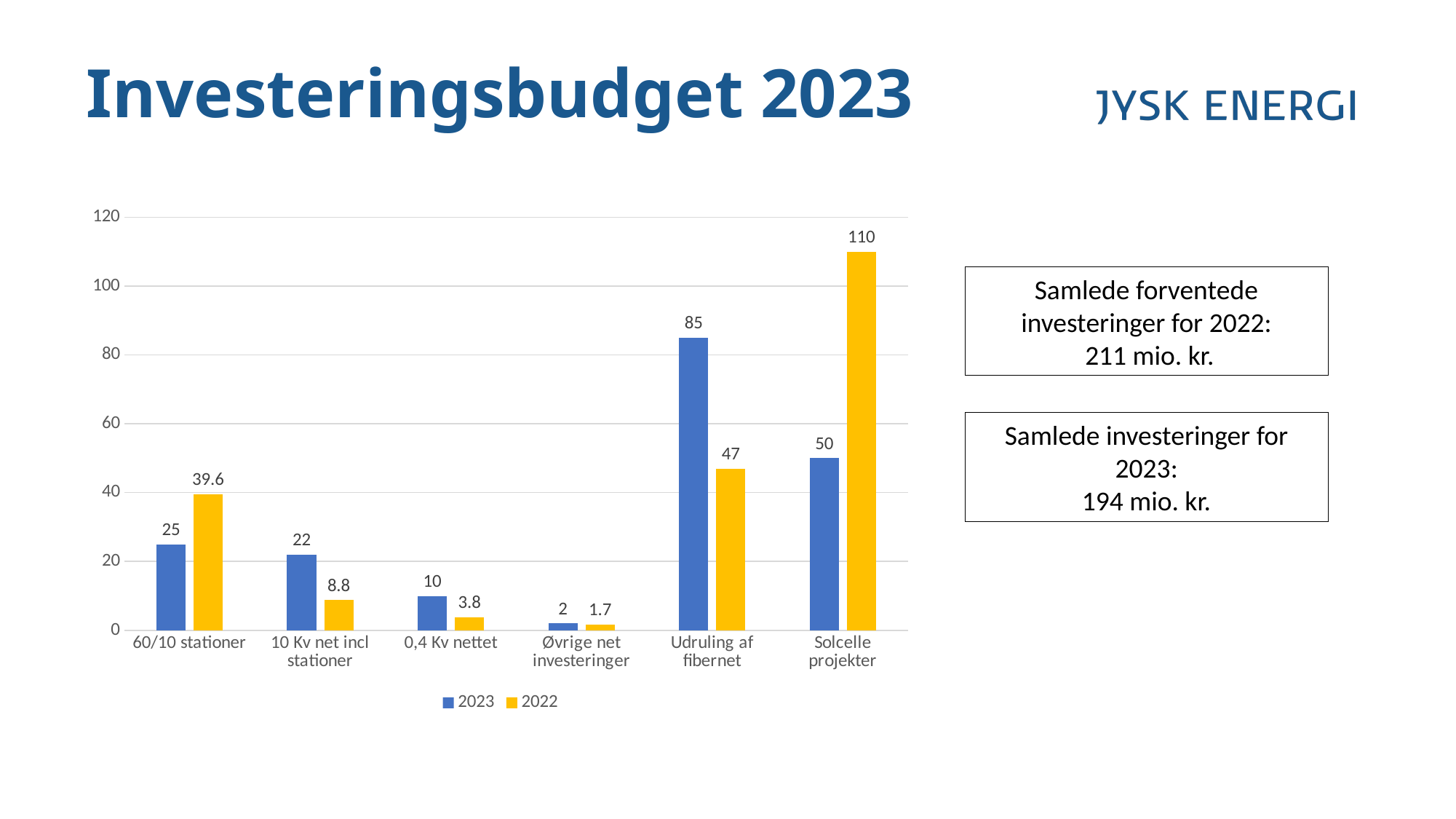
Which colour represents the 2022 series? Yellow Which category has the highest 2023 value? Udruling af fibernet What is the 2022 value for Solcelle projekter? 110 What is the 2023 value for 10 Kv net incl stationer? 22 Which is larger for 0,4 Kv nettet: the 2023 value or the 2022 value? 2023 What is the difference between the 2022 and 2023 values for Solcelle projekter? 60 How many series does the legend list? 2 What is the 2022 value for 60/10 stationer? 39.6 What kind of chart is shown on the slide? Bar chart Which category has the lowest 2022 value? Øvrige net investeringer How many categories are shown on the x axis? 6 What is the 2023 value for Udruling af fibernet? 85